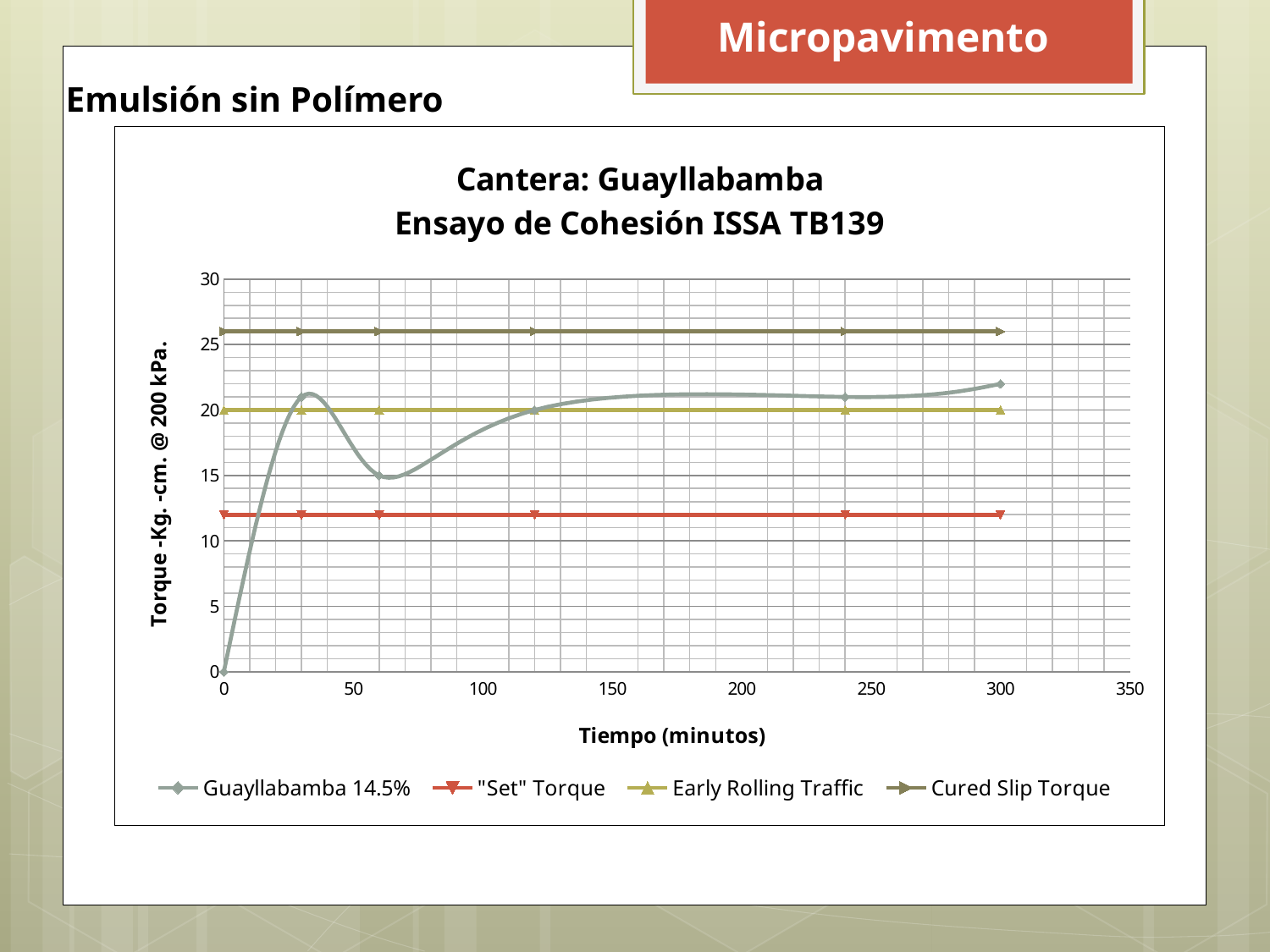
What kind of chart is shown on the slide? line chart Does the Guayllabamba 14.5% series rise or fall between 0 and 30 minutes? rise Is the value of the Guayllabamba 14.5% series at 300 minutes greater or less than 20? greater Is the value of the "Set" Torque line greater or less than 15? less What is the value of the Early Rolling Traffic line? 20 Which series has the highest values on the chart? Cured Slip Torque What is the label of the x axis? Tiempo (minutos) How many series does the legend list? 4 What is the title of the chart? Cantera: Guayllabamba Ensayo de Cohesión ISSA TB139 How many data points are plotted for the Guayllabamba 14.5% series? 6 Is the value of the Cured Slip Torque line greater or less than 25? greater What is the value of the Guayllabamba 14.5% series at 0 minutes? 0